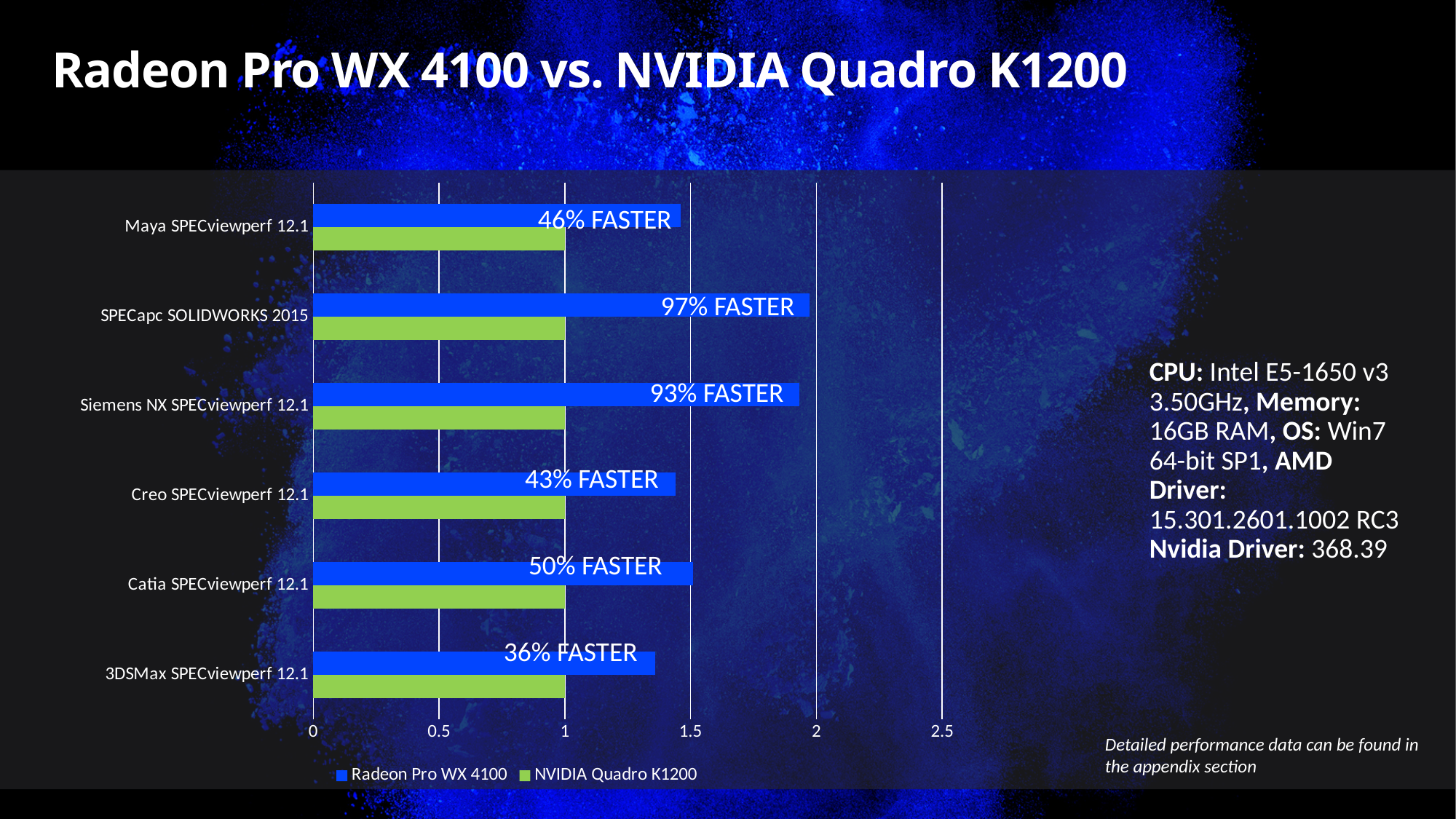
What is the value of the NVIDIA Quadro K1200 bar for Creo SPECviewperf 12.1? 1 How many benchmark categories are plotted on the chart? 6 What label is printed on the Radeon Pro WX 4100 bar for 3DSMax SPECviewperf 12.1? 36% FASTER Is the Radeon Pro WX 4100 value for 3DSMax SPECviewperf 12.1 greater or less than 1.5? less Is the Radeon Pro WX 4100 value for Maya SPECviewperf 12.1 greater or less than 1? greater How many series does the legend list? 2 Which colour represents the NVIDIA Quadro K1200 in the legend? green What label is printed on the Radeon Pro WX 4100 bar for SPECapc SOLIDWORKS 2015? 97% FASTER In which benchmark is the Radeon Pro WX 4100 bar the longest? SPECapc SOLIDWORKS 2015 Which has the longer Radeon Pro WX 4100 bar, Siemens NX SPECviewperf 12.1 or Creo SPECviewperf 12.1? Siemens NX SPECviewperf 12.1 In which benchmark is the Radeon Pro WX 4100 bar the shortest? 3DSMax SPECviewperf 12.1 What kind of chart is shown on the slide? bar chart